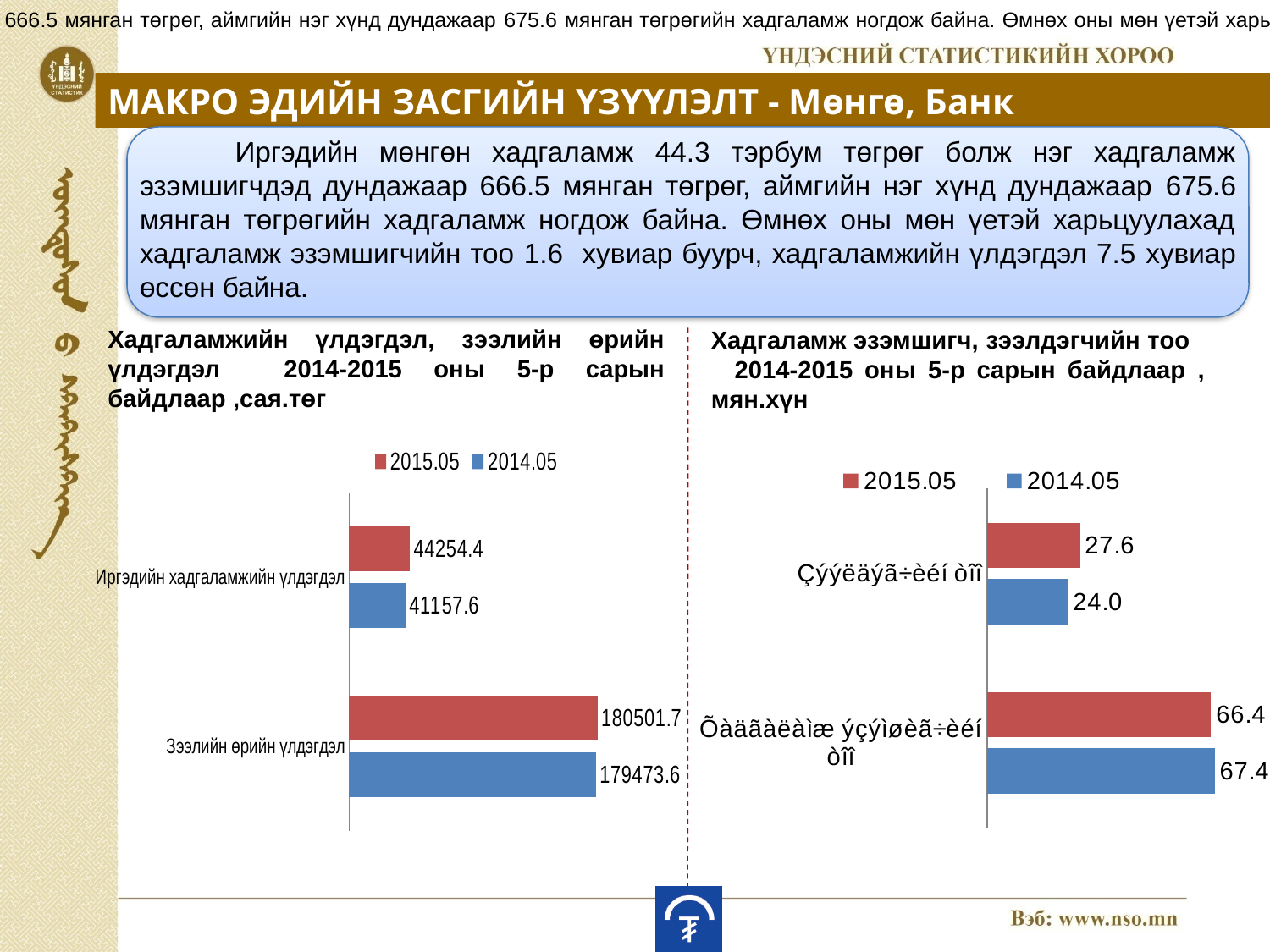
In the left chart (Хадгаламжийн үлдэгдэл, зээлийн өрийн үлдэгдэл), what is the 2015.05 value for Зээлийн өрийн үлдэгдэл? 180501.7 In the right chart (Хадгаламж эзэмшигч, зээлдэгчийн тоо), for the bottom category, which is larger: the 2015.05 value or the 2014.05 value? 2014.05 In the right chart (Хадгаламж эзэмшигч, зээлдэгчийн тоо), what is the difference between the 2015.05 and 2014.05 values for the top category? 3.6 In the right chart (Хадгаламж эзэмшигч, зээлдэгчийн тоо), what is the 2014.05 value for the bottom category? 67.4 In the left chart (Хадгаламжийн үлдэгдэл, зээлийн өрийн үлдэгдэл), what is the 2014.05 value for Зээлийн өрийн үлдэгдэл? 179473.6 In the left chart (Хадгаламжийн үлдэгдэл, зээлийн өрийн үлдэгдэл), how many series does the legend list? 2 In the right chart (Хадгаламж эзэмшигч, зээлдэгчийн тоо), what is the 2015.05 value for the top category? 27.6 What kind of chart is the left chart (Хадгаламжийн үлдэгдэл, зээлийн өрийн үлдэгдэл)? Bar chart In the left chart (Хадгаламжийн үлдэгдэл, зээлийн өрийн үлдэгдэл), what is the difference between the 2015.05 and 2014.05 values for Иргэдийн хадгаламжийн үлдэгдэл? 3096.8 In the left chart (Хадгаламжийн үлдэгдэл, зээлийн өрийн үлдэгдэл), which category has the highest value? Зээлийн өрийн үлдэгдэл In the left chart (Хадгаламжийн үлдэгдэл, зээлийн өрийн үлдэгдэл), what is the 2015.05 value for Иргэдийн хадгаламжийн үлдэгдэл? 44254.4 In the right chart (Хадгаламж эзэмшигч, зээлдэгчийн тоо), which colour represents the 2015.05 series? Red